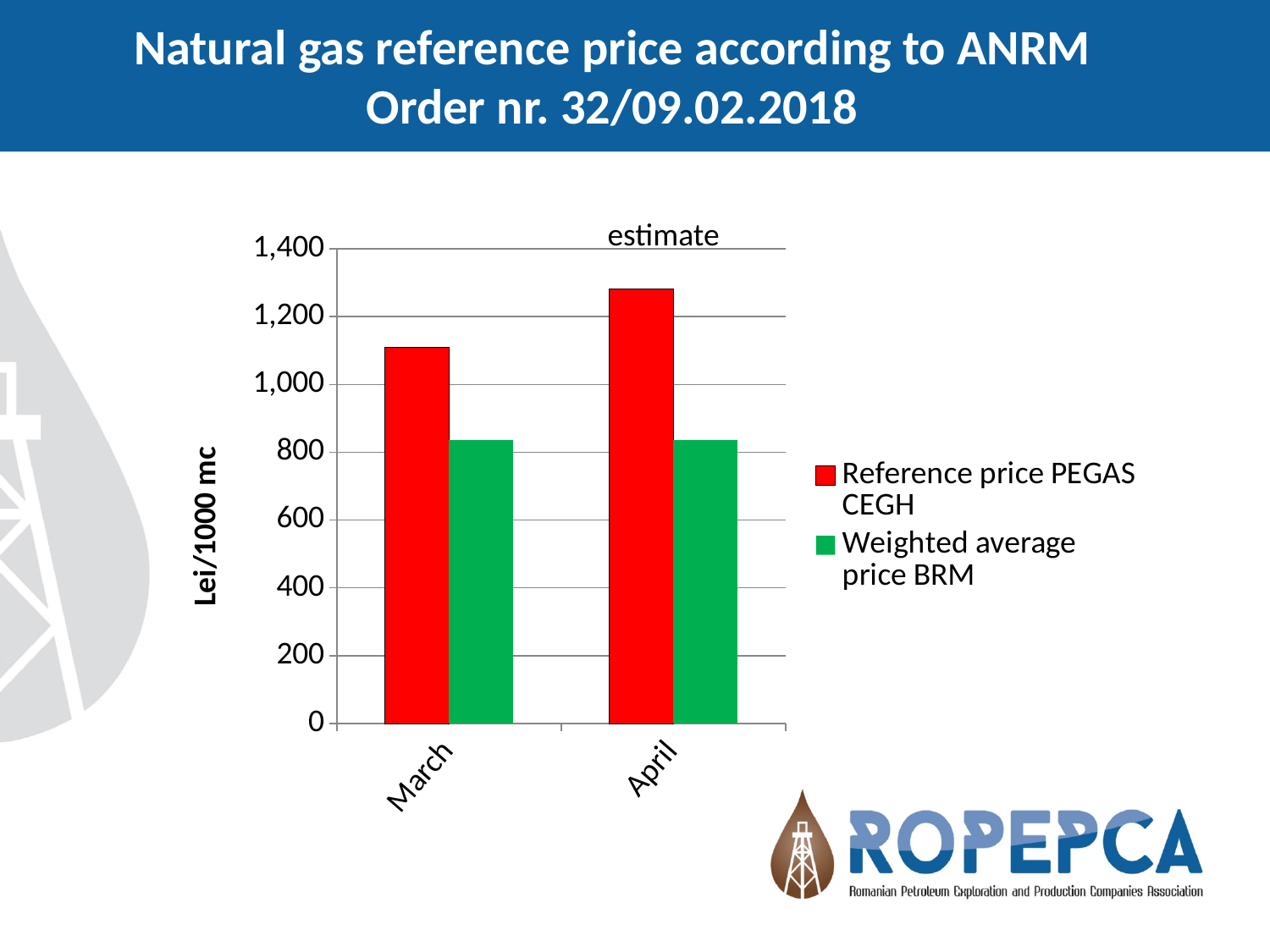
Which series is shown in red? Reference price PEGAS CEGH Is the Weighted average price BRM for March greater or less than 1,000? less For the Reference price PEGAS CEGH series, which month has the higher value? April How many categories are shown on the x axis? 2 Does the Reference price PEGAS CEGH rise or fall from March to April? rise In April, which is larger: the Reference price PEGAS CEGH or the Weighted average price BRM? Reference price PEGAS CEGH How many series does the legend list? 2 Is the Reference price PEGAS CEGH for March greater or less than 1,000? greater Is the Weighted average price BRM for April greater or less than 800? greater What kind of chart is shown on the slide? bar chart What is the label on the vertical axis? Lei/1000 mc